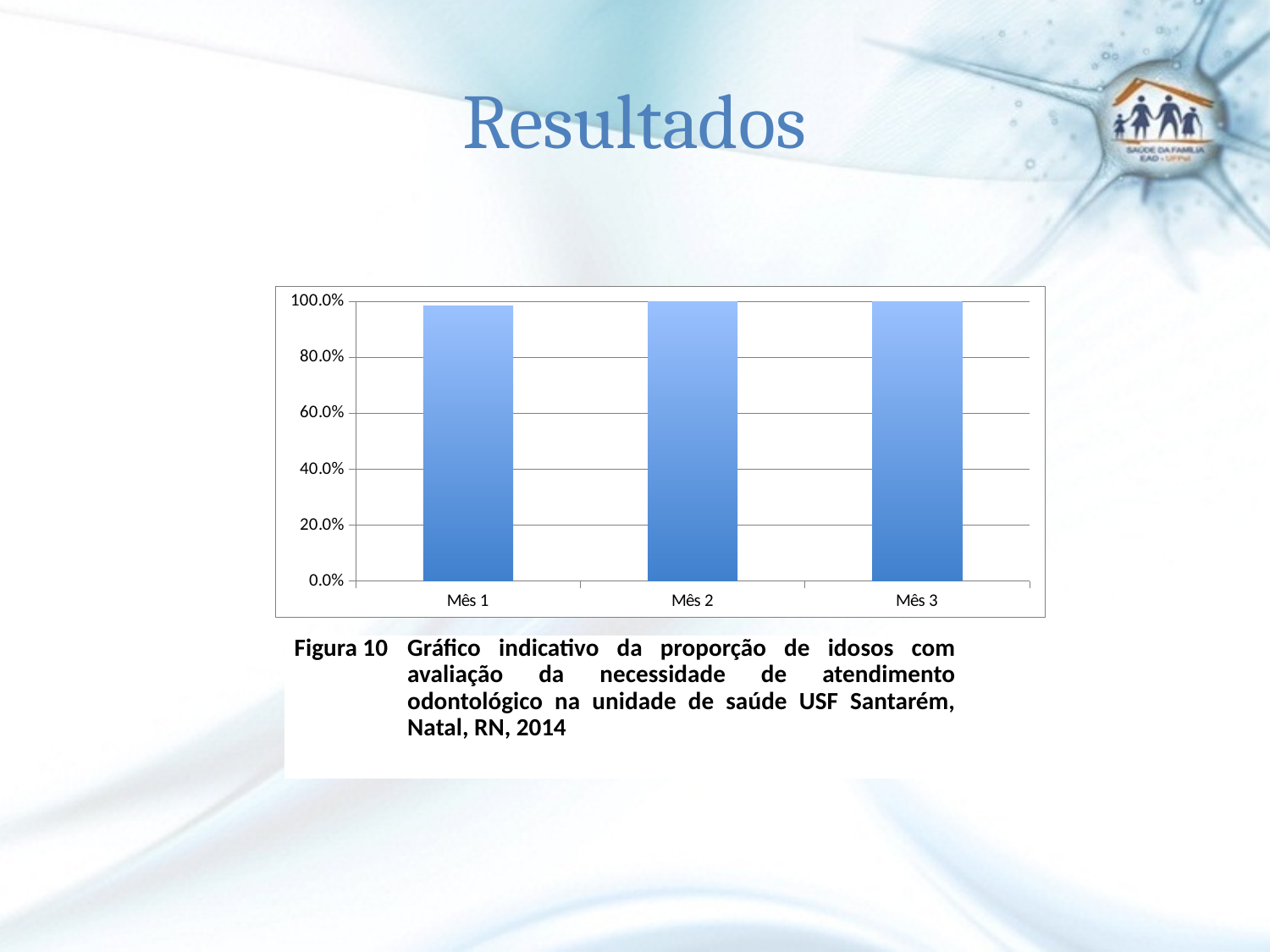
Which category has the lowest value? Mês 1 What is the highest value shown on the y axis of the chart? 100.0% How many categories are shown on the x axis of the chart? 3 What figure number is given in the caption below the chart? Figura 10 Is the value for Mês 1 greater or less than 100.0%? less Which is larger, the value for Mês 1 or the value for Mês 2? Mês 2 Is the value for Mês 1 greater or less than 80.0%? greater What is the value for Mês 3? 100.0% What kind of chart is shown on the slide? bar chart What is the value for Mês 2? 100.0%